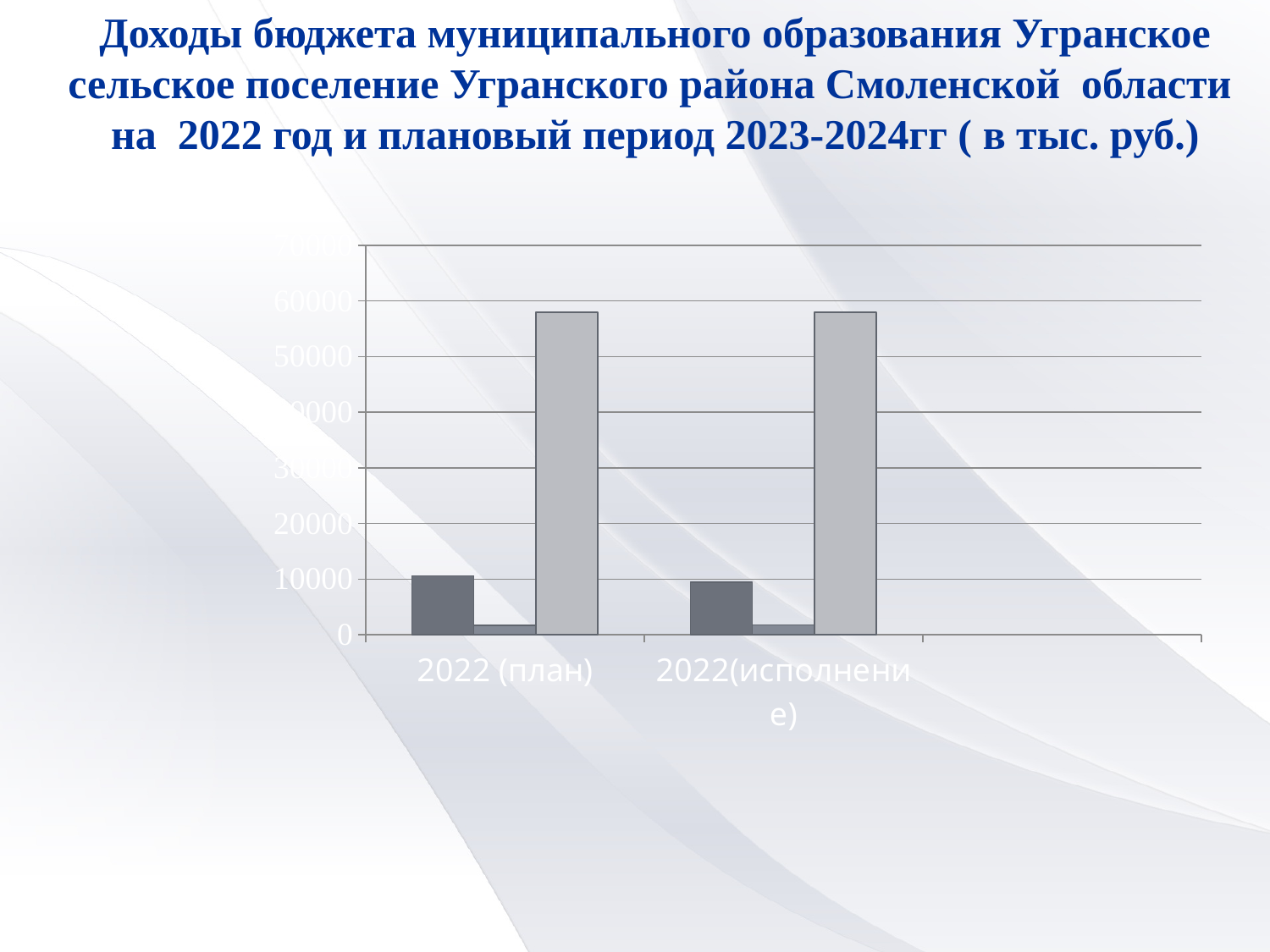
Is the value of the shortest (medium grey) bar for 2022(исполнение) greater or less than 10000? less Within the 2022(исполнение) category, which bar is the shortest: the dark grey, medium grey or light grey one? medium grey What is the highest value shown on the y axis of the chart? 70000 Is the value of the tallest (light grey) bar for 2022(исполнение) greater or less than 50000? greater How many categories are shown on the x axis of the chart? 2 Within the 2022 (план) category, which bar is the tallest: the dark grey, medium grey or light grey one? light grey Is the value of the tallest (light grey) bar for 2022 (план) greater or less than 50000? greater What kind of chart is shown on the slide? bar chart In the 2022 (план) category, which is larger: the dark grey bar or the light grey bar? light grey bar What are the two category labels on the x axis of the chart? 2022 (план) and 2022(исполнение)